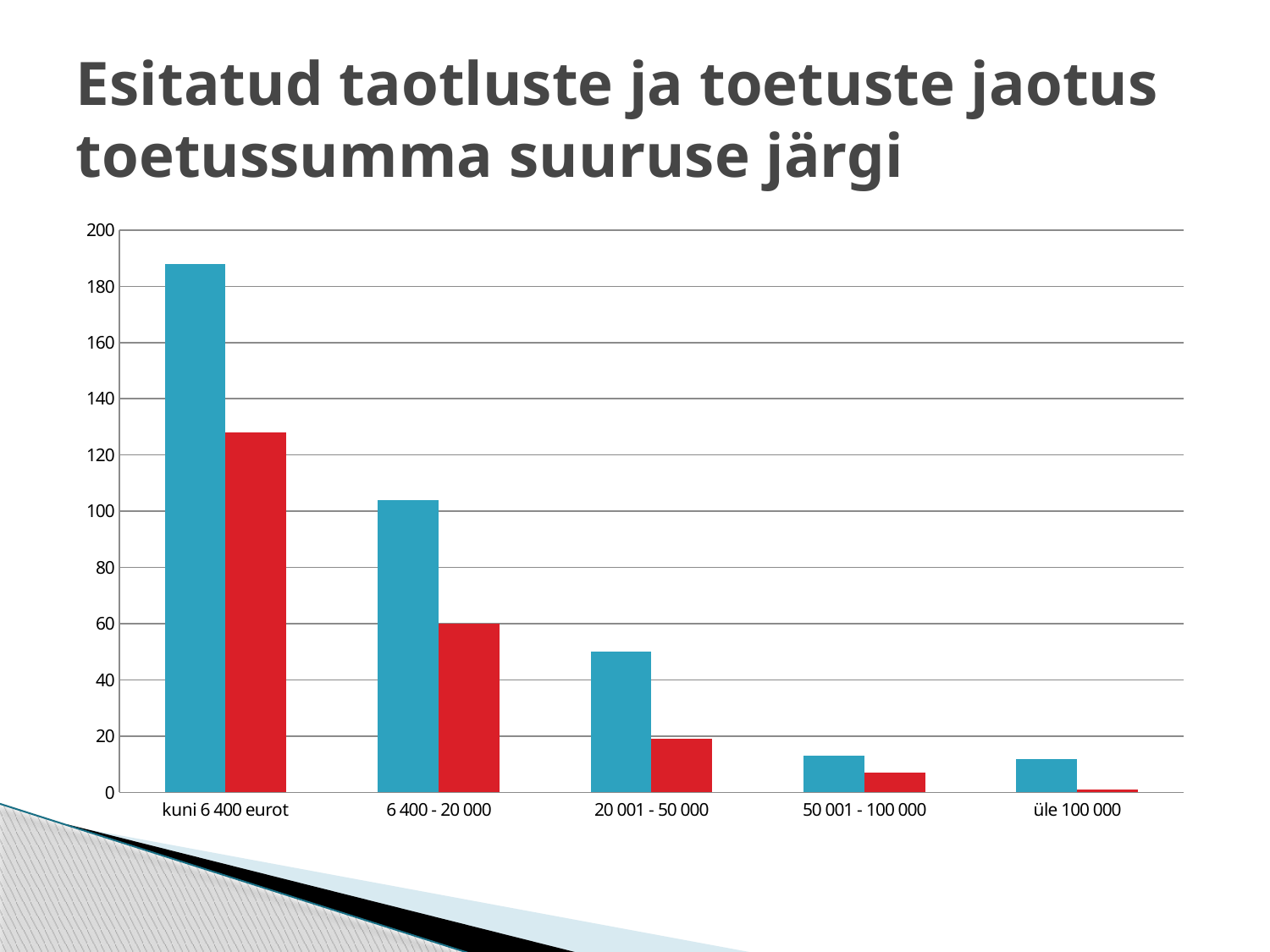
Do the blue bars rise or fall from left to right along the x axis? fall Is the red bar for kuni 6 400 eurot greater or less than 140? less Is the blue bar for 50 001 - 100 000 greater or less than 20? less Is the blue bar for kuni 6 400 eurot greater or less than 180? greater How many categories are shown on the x axis? 5 Which category has the tallest blue bar? kuni 6 400 eurot Which category has the shortest red bar? üle 100 000 What is the title of the slide? Esitatud taotluste ja toetuste jaotus toetussumma suuruse järgi What kind of chart is shown on the slide? bar chart In the 6 400 - 20 000 category, which bar is taller, the blue one or the red one? the blue one